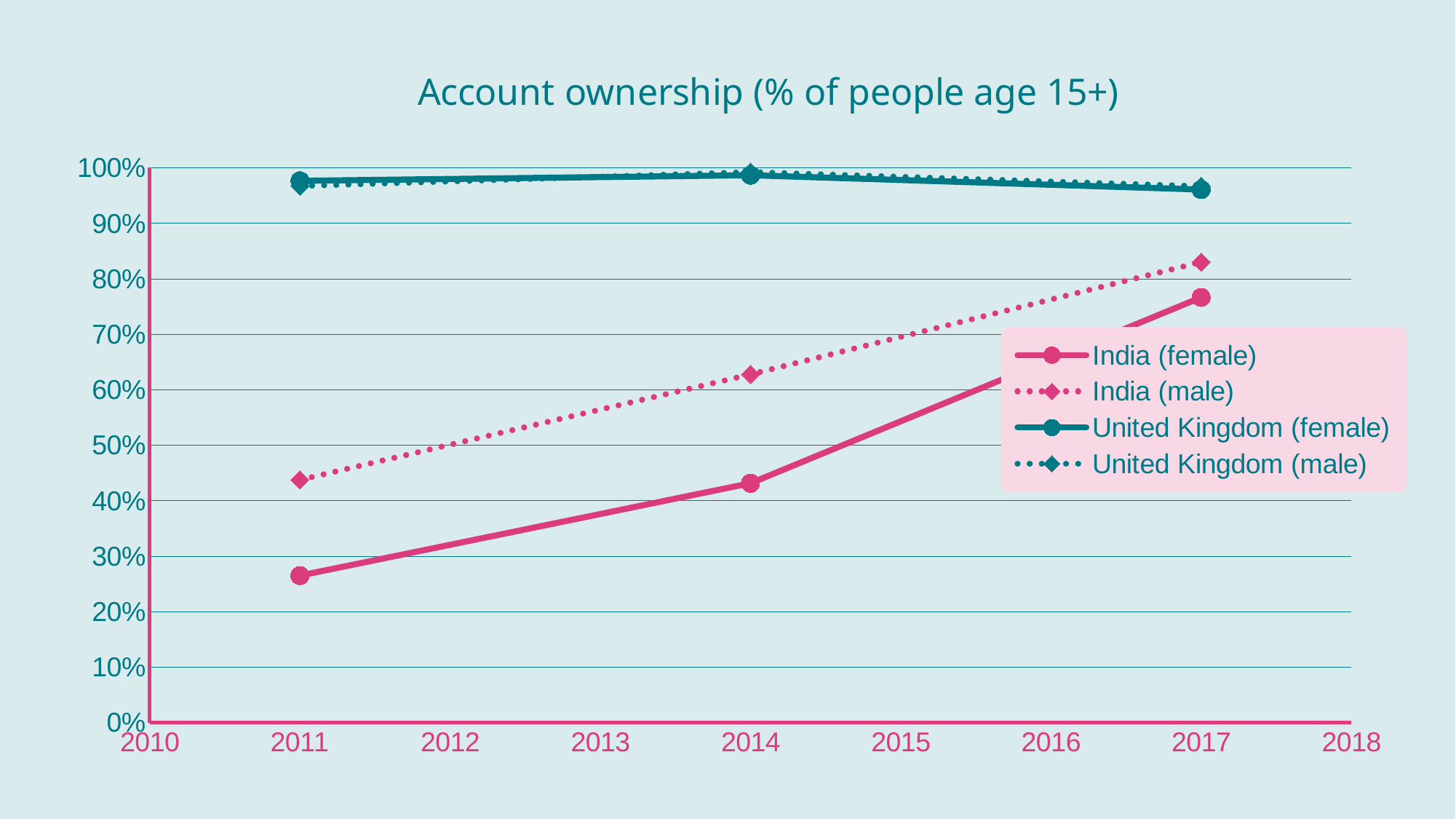
What kind of chart is shown on the slide? line chart Is the value for India (female) in 2014 greater or less than 50%? less In which year is the India (female) value lowest? 2011 In 2014, which is larger: India (male) or India (female)? India (male) How many data points are plotted for the India (female) series? 3 What is the title of the chart? Account ownership (% of people age 15+) Does the India (female) series rise or fall from 2011 to 2017? rise Is the value for India (female) in 2011 greater or less than 30%? less Is the value for India (male) in 2017 greater or less than 80%? greater How many series does the legend list? 4 Does the India (male) series rise or fall from 2011 to 2017? rise